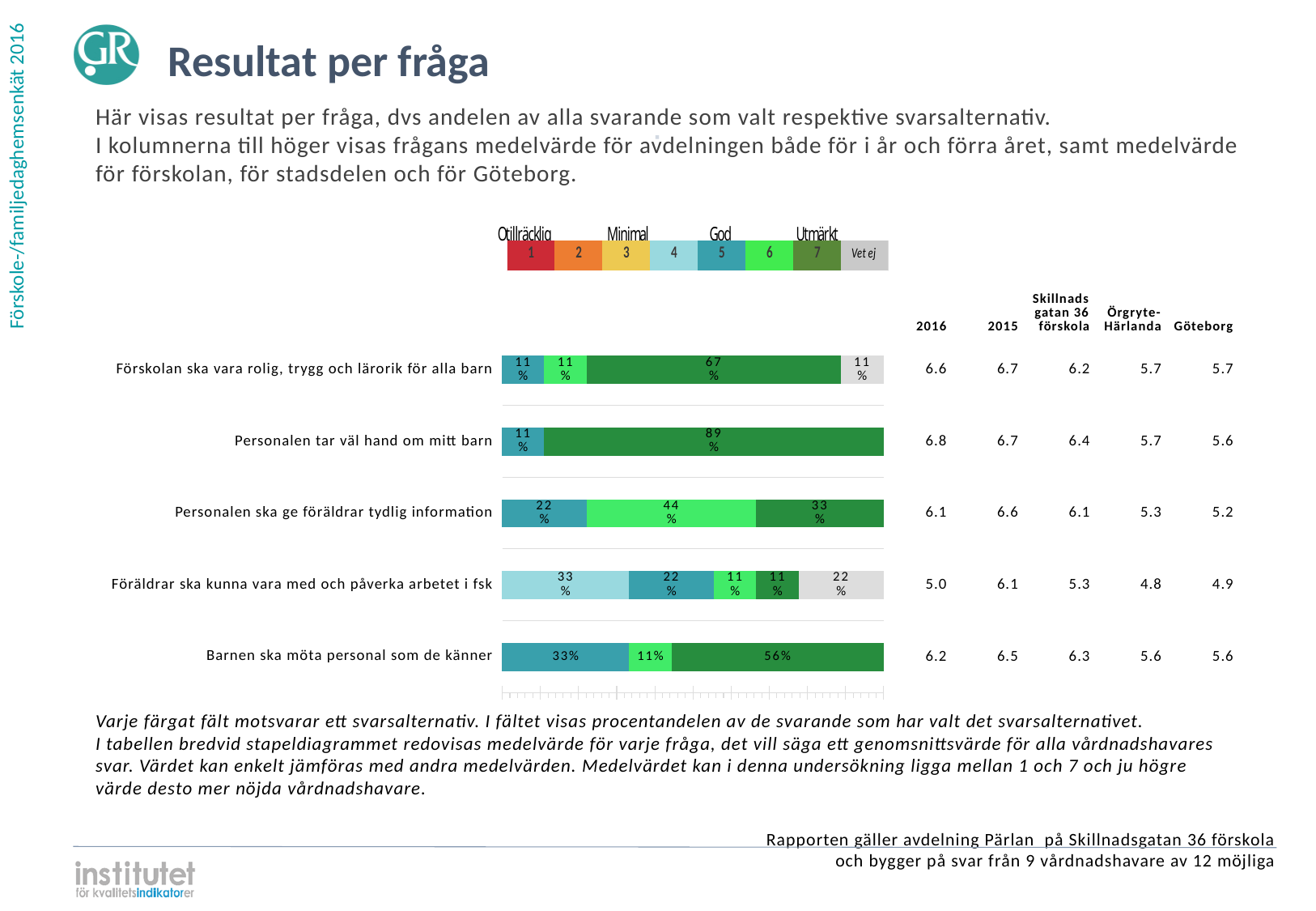
What percentage of respondents chose answer 4 (light blue) for 'Föräldrar ska kunna vara med och påverka arbetet i fsk'? 33% What type of chart is shown on the slide? stacked bar chart Which question has the largest share of respondents choosing answer 7 (dark green)? Personalen tar väl hand om mitt barn What is the difference between the answer 7 share for 'Personalen tar väl hand om mitt barn' and for 'Förskolan ska vara rolig, trygg och lärorik för alla barn'? 22 percentage points What percentage of respondents chose answer 7 (dark green) for 'Barnen ska möta personal som de känner'? 56% What percentage of respondents chose answer 6 (light green) for 'Personalen ska ge föräldrar tydlig information'? 44% What is the combined share of answers 6 and 7 for 'Personalen ska ge föräldrar tydlig information'? 77% Which is larger: the 'Vet ej' share for 'Föräldrar ska kunna vara med och påverka arbetet i fsk' or for 'Förskolan ska vara rolig, trygg och lärorik för alla barn'? Föräldrar ska kunna vara med och påverka arbetet i fsk What percentage of respondents chose answer 7 (dark green) for 'Personalen tar väl hand om mitt barn'? 89% Which question has the smallest share of respondents choosing answer 7 (dark green)? Föräldrar ska kunna vara med och påverka arbetet i fsk How many questions (categories) are plotted in the bar chart? 5 How many answer alternatives does the legend above the chart list? 8